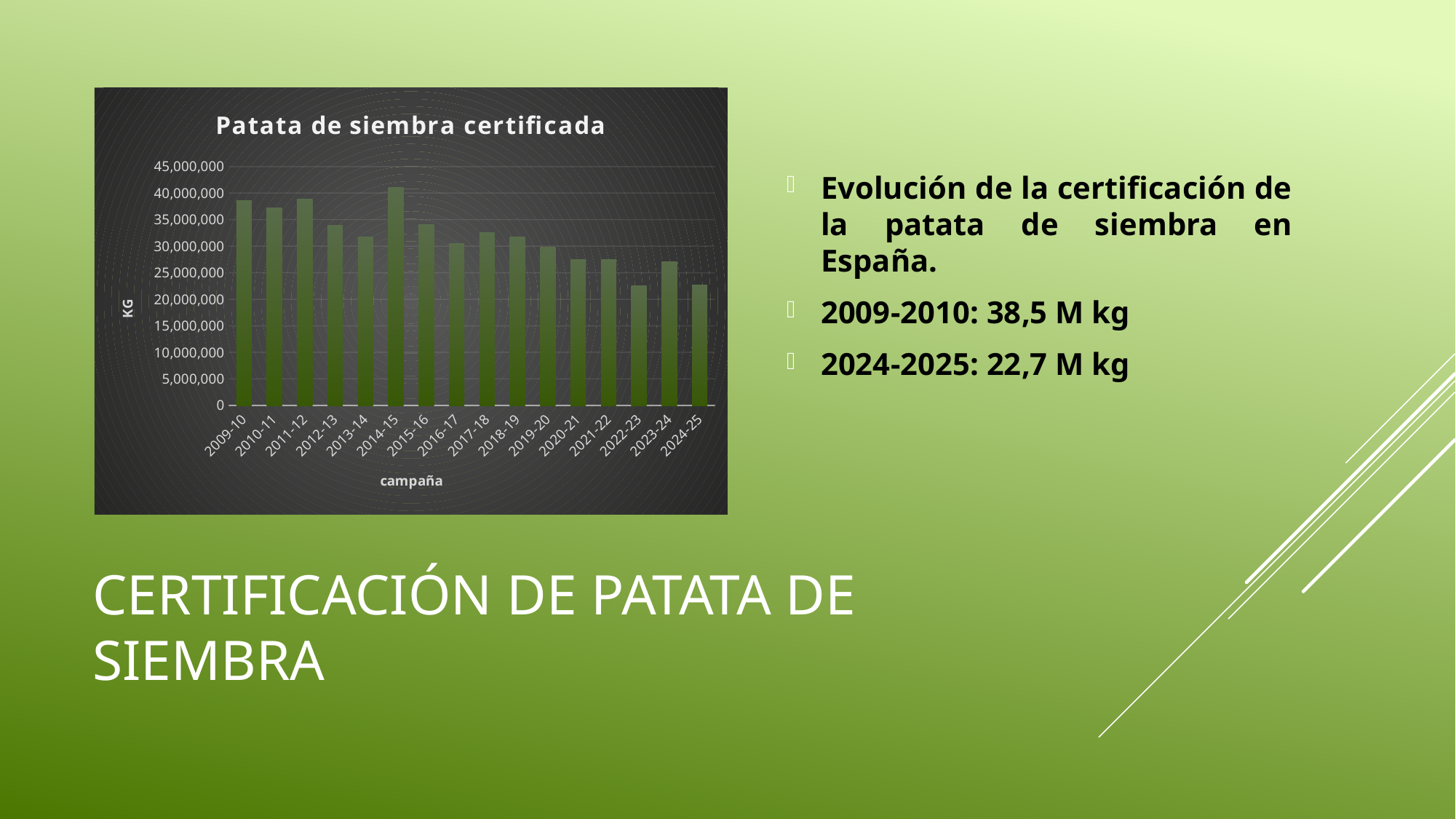
Is the value for 2022-23 greater or less than 25,000,000? less What label is shown on the vertical axis of the chart? KG What is the title of the chart? Patata de siembra certificada According to the slide, what was the certified seed potato amount for 2009-2010? 38,5 M kg Is the value for 2014-15 greater or less than 40,000,000? greater Which is larger, the value for 2011-12 or the value for 2012-13? 2011-12 How many campaigns (categories) are plotted on the x axis of the chart? 16 Do the values in the chart generally rise or fall from 2009-10 to 2024-25? fall What kind of chart is shown on the slide? bar chart Is the value for 2020-21 greater or less than 30,000,000? less Which campaign has the highest certified seed potato value in the chart? 2014-15